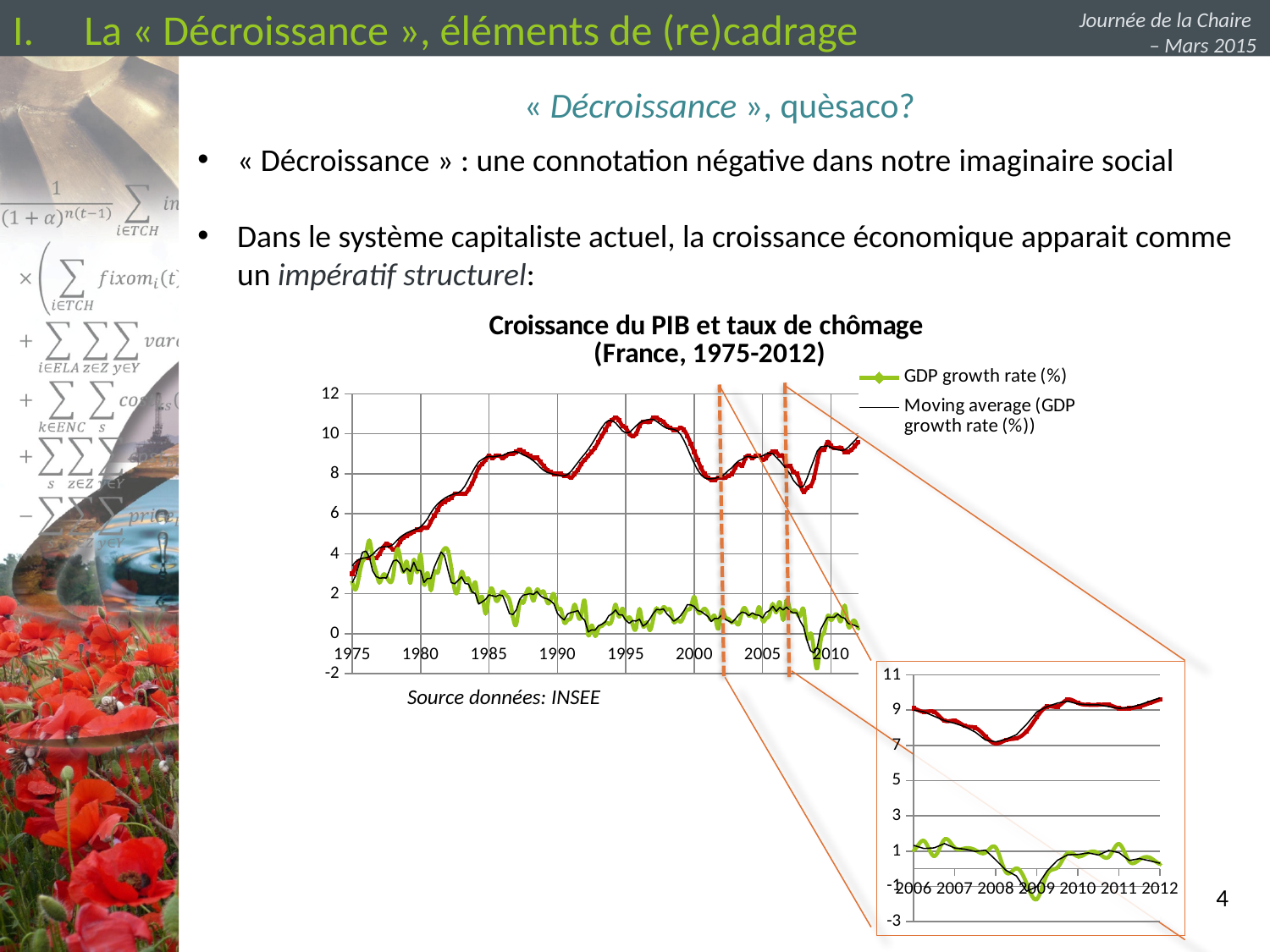
What is the title of the main chart on the slide? Croissance du PIB et taux de chômage (France, 1975-2012) In the inset chart at the bottom right, does the red line rise or fall between 2008 and 2009? rise How many series does the legend of the main chart list? 2 In the main chart, is the GDP growth rate (%) in 2009 greater or less than 0? less In the main chart, is the GDP growth rate (%) in 1975 greater or less than 2? greater What kind of chart is shown under the title 'Croissance du PIB et taux de chômage'? line chart In the main chart, is the GDP growth rate (%) in 1985 greater or less than 4? less What data source is cited below the main chart? INSEE In the main chart, does the GDP growth rate (%) overall rise or fall from 1975 to 2012? fall